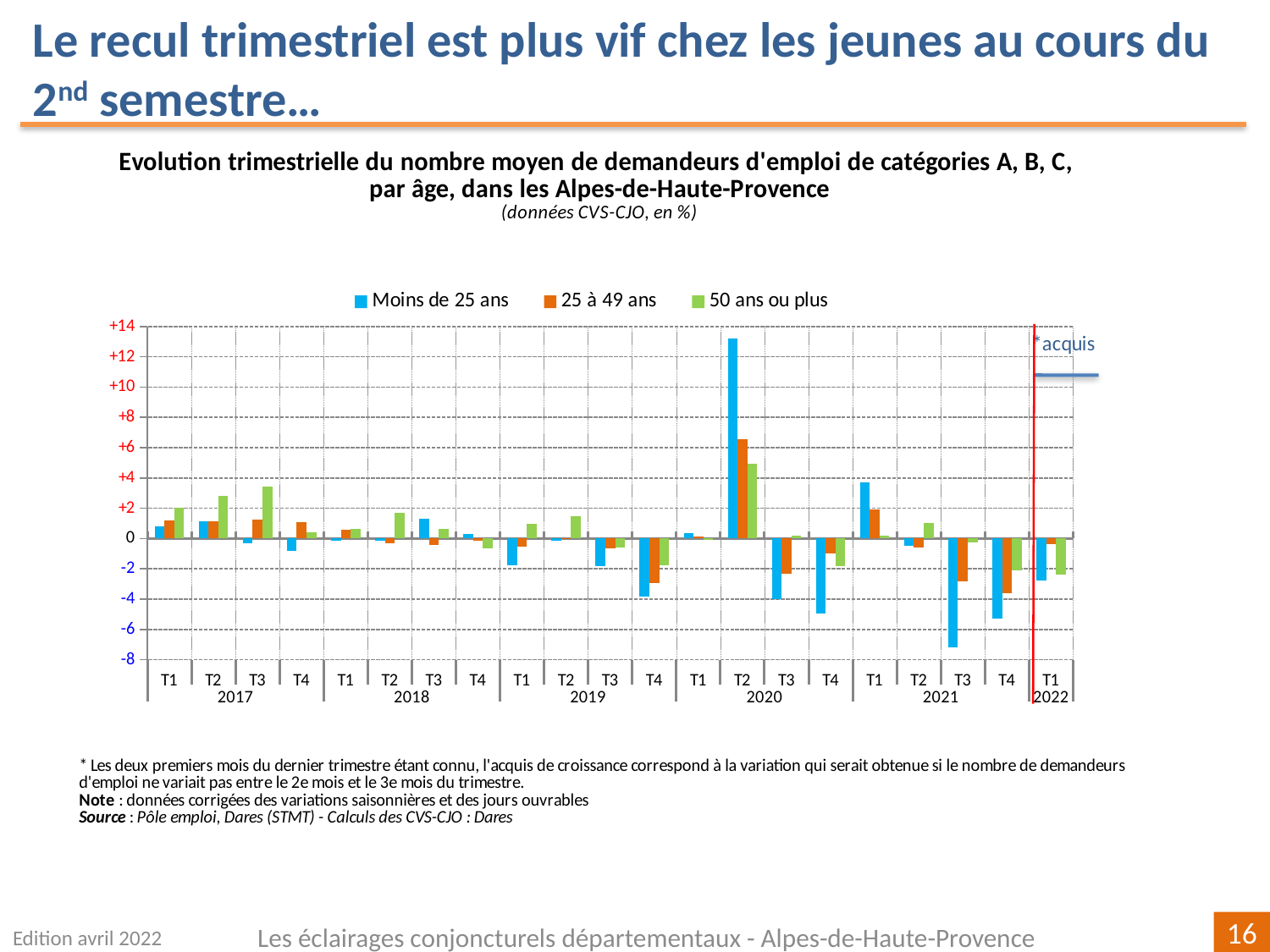
Is the value for '25 à 49 ans' in T2 2020 greater or less than +4? greater In which quarter does the 'Moins de 25 ans' series reach its lowest value? T3 2021 In T3 2017, which series has the larger value: 'Moins de 25 ans' or '50 ans ou plus'? 50 ans ou plus In which quarter does the 'Moins de 25 ans' series reach its highest value? T2 2020 Is the value for 'Moins de 25 ans' in T4 2020 greater or less than -4? less What kind of chart is shown on the slide? bar chart Is the value for 'Moins de 25 ans' in T3 2021 greater or less than -6? less Which series is shown in blue in the legend? Moins de 25 ans How many series does the legend list? 3 In T2 2020, which series has the larger value: 'Moins de 25 ans' or '25 à 49 ans'? Moins de 25 ans How many quarters are shown along the x axis? 21